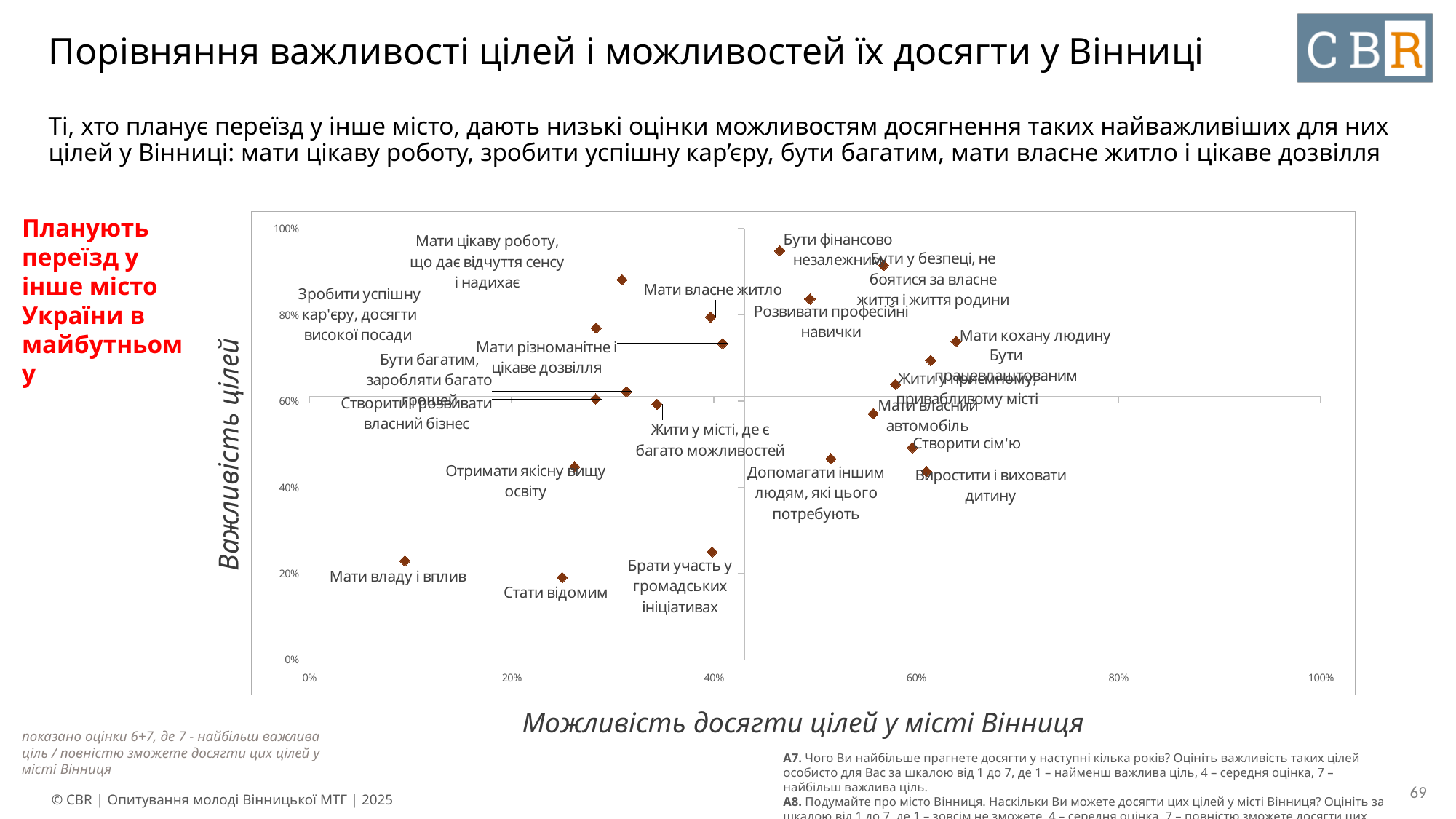
Is the importance value for "Бути фінансово незалежним" greater or less than 80%? greater Which goal has the highest importance (vertical axis value) on the chart? Бути фінансово незалежним Is the importance value for "Брати участь у громадських ініціативах" greater or less than 40%? less What kind of chart is shown on the slide? Scatter chart What is the title of the horizontal axis of the chart? Можливість досягти цілей у місті Вінниця Which goal has the lowest value on the horizontal axis (possibility to achieve in Vinnytsia)? Мати владу і вплив Which goal has a higher horizontal-axis value: "Мати владу і вплив" or "Мати кохану людину"? Мати кохану людину What is the title of the vertical axis of the chart? Важливість цілей Is the horizontal-axis value for "Мати кохану людину" greater or less than 60%? greater